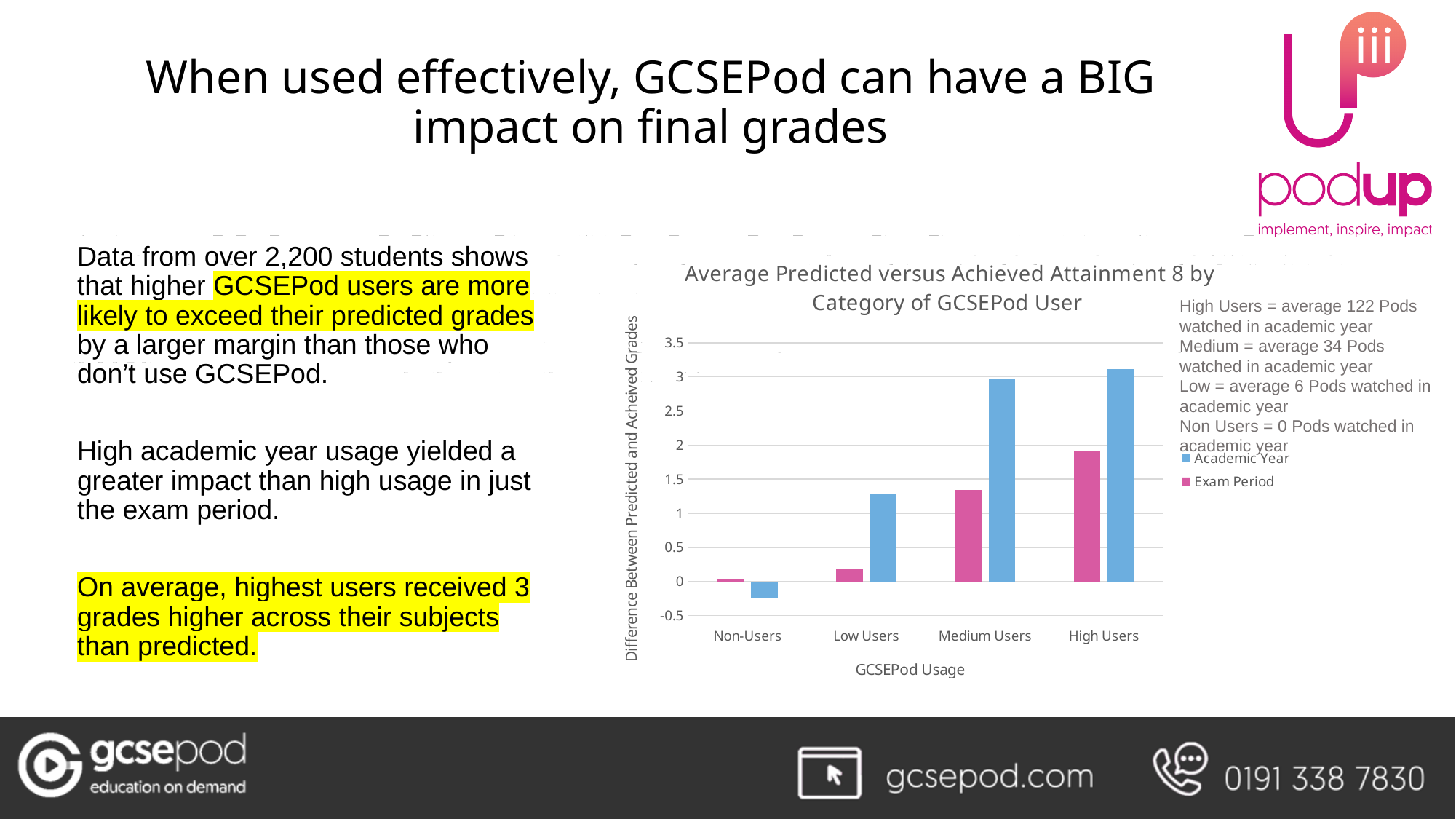
How many series does the legend list? 2 How many categories of GCSEPod usage are shown on the x axis? 4 Which category has the highest Exam Period value? High Users Is the Academic Year value for Non-Users greater or less than 0? less Is the Exam Period value for Low Users greater or less than 0.5? less What is the label on the x axis of the chart? GCSEPod Usage Is the Exam Period value for High Users greater or less than 1.5? greater Which category has the lowest Academic Year value? Non-Users Do the Exam Period values rise or fall from Non-Users to High Users? Rise For Medium Users, which is larger: the Academic Year value or the Exam Period value? Academic Year What kind of chart is shown on the slide? Bar chart